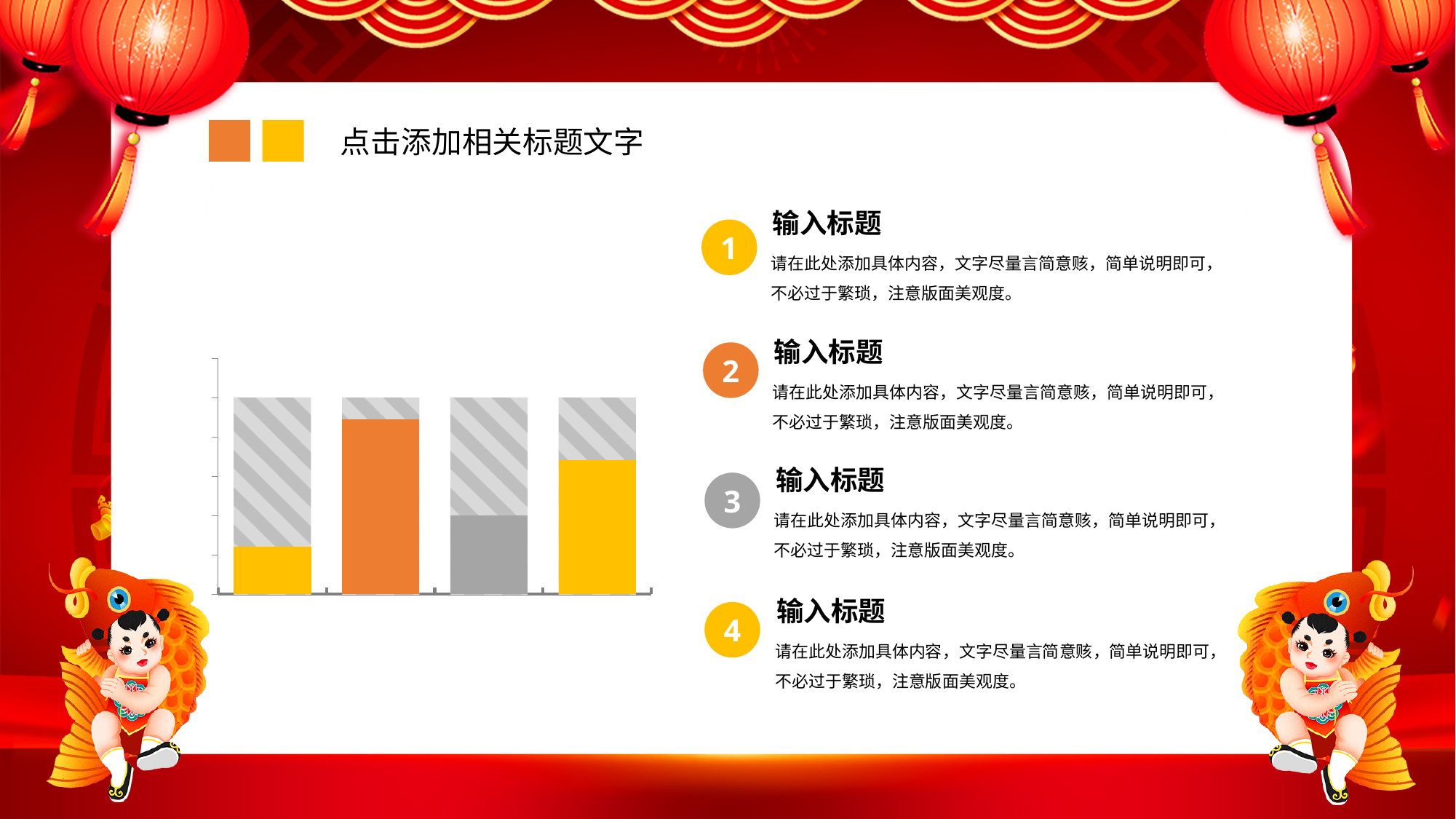
What kind of chart is shown on the slide? bar chart What colour is the tallest bar in the chart? orange Does the chart display any data labels or axis values? No Which is taller in the chart, the third bar or the first bar? the third bar Which bar in the chart is the tallest, counting from the left? the second bar Which bar in the chart is the shortest, counting from the left? the first bar Which is taller in the chart, the second bar or the fourth bar? the second bar